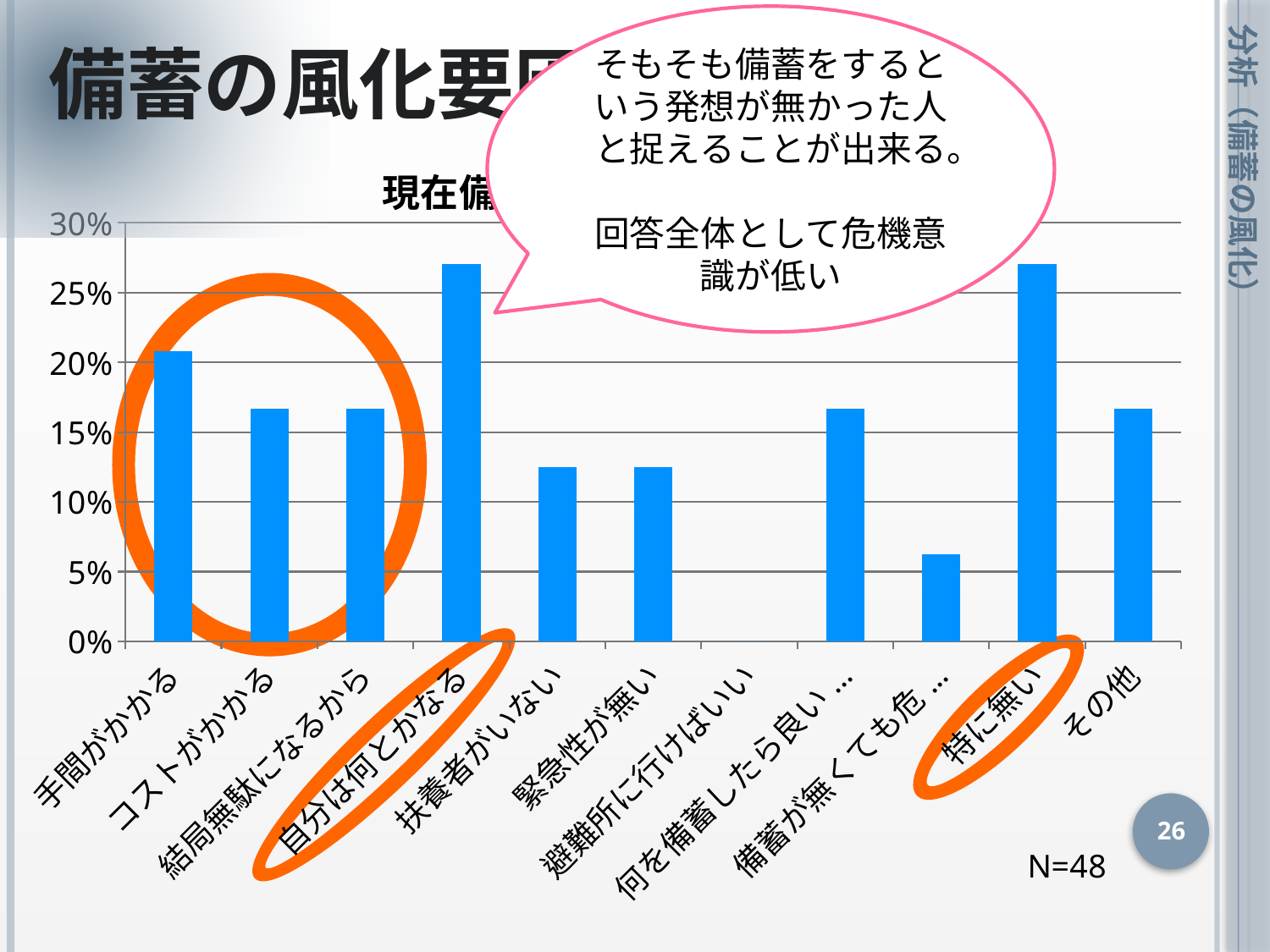
Is the value for コストがかかる greater or less than 20%? less What sample size (N) is shown below the chart? N=48 Which is larger, the value for 手間がかかる or the value for コストがかかる? 手間がかかる How many categories are shown on the x axis of the chart? 11 Which category has the lowest value in the chart? 避難所に行けばいい Which is larger, the value for 自分は何とかなる or the value for 扶養者がいない? 自分は何とかなる What is the value for 避難所に行けばいい? 0% Is the value for 扶養者がいない greater or less than 10%? greater Is the value for 自分は何とかなる greater or less than 25%? greater What kind of chart is shown on the slide? bar chart